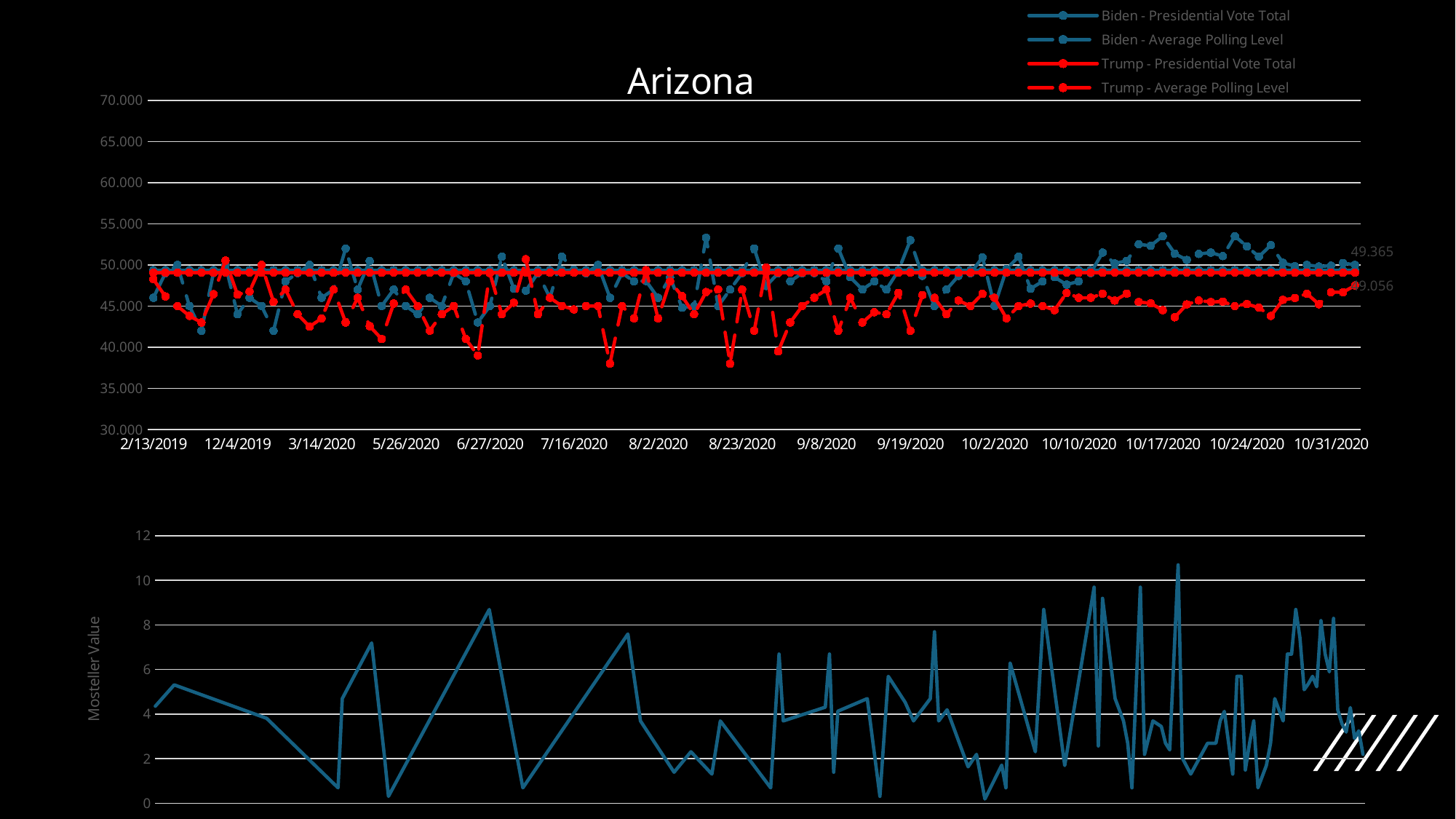
In the top chart, what value is labeled for Trump - Presidential Vote Total? 49.056 What kind of chart is the top chart titled "Arizona"? line chart In the top chart, what is the difference between the Biden and Trump Presidential Vote Total labels? 0.309 In the top chart, is the lowest point of Trump - Average Polling Level greater or less than 40.000? less How many series does the legend of the top chart list? 4 In the top chart, which is larger: the Biden Presidential Vote Total or the Trump Presidential Vote Total? Biden - Presidential Vote Total What kind of chart is the bottom chart? line chart What is the title of the top chart? Arizona What is the y-axis title of the bottom chart? Mosteller Value In the top chart, what value is labeled for Biden - Presidential Vote Total? 49.365 In the top chart, is the highest point of Biden - Average Polling Level greater or less than 55.000? less In the bottom chart, is the highest Mosteller Value greater or less than 10? greater